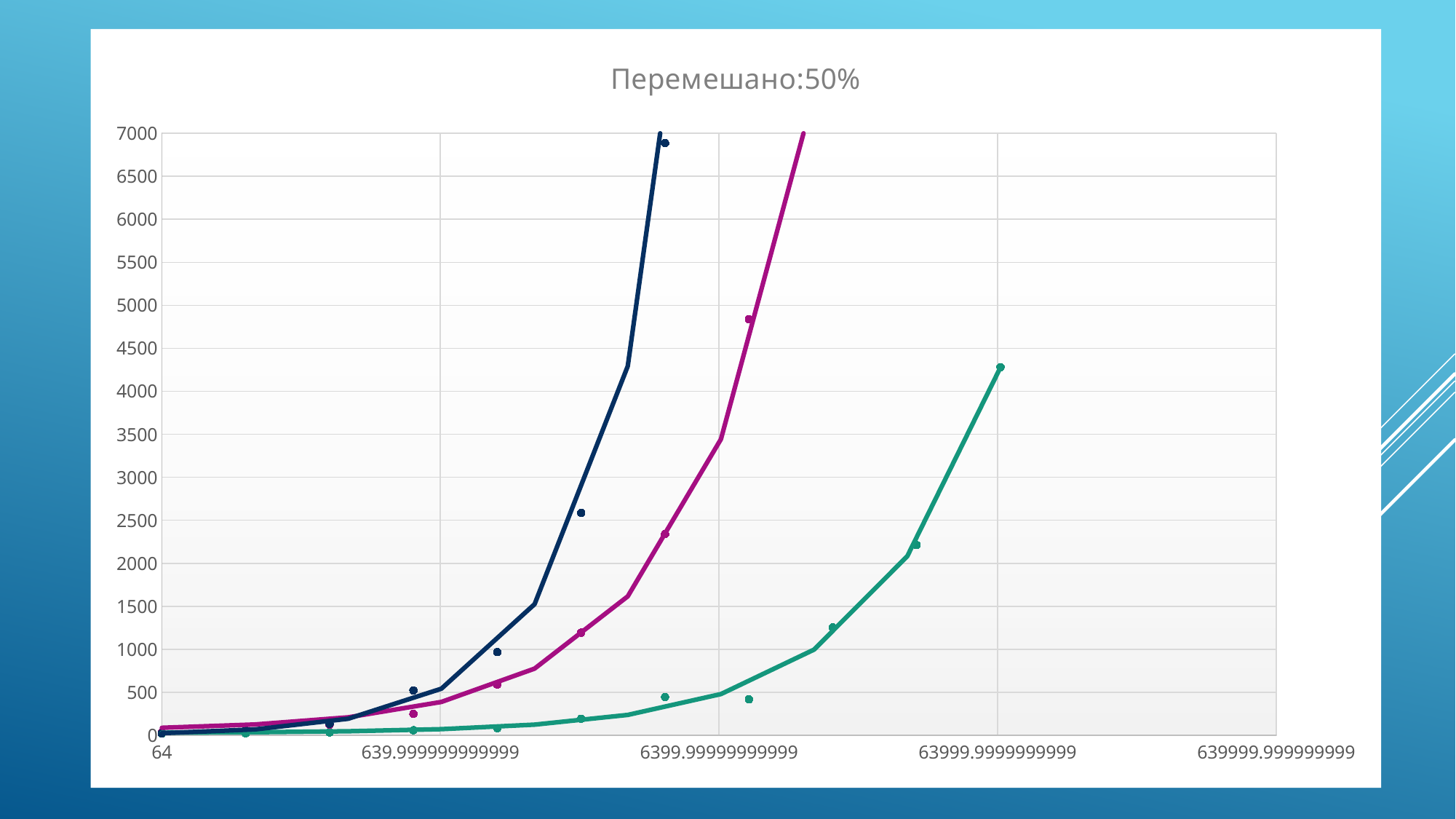
What is the title of the chart? Перемешано:50% How many differently coloured series are plotted on the chart? 3 What is the highest value shown on the y axis? 7000 Near x = 6399.99999999999, which series has the larger value: the dark blue series or the teal series? the dark blue series Is the highest point of the teal (green) series greater or less than 4000? greater Which series stays lowest across the x axis? the teal (green) series Is the highest point of the dark blue series greater or less than 6500? greater Which series reaches the highest y value on the chart? the dark blue series Do the values of the series rise or fall as the x axis increases? rise What kind of chart is shown on the slide? scatter chart with trend lines Is the value of the teal series near x = 6399.99999999999 greater or less than 1000? less